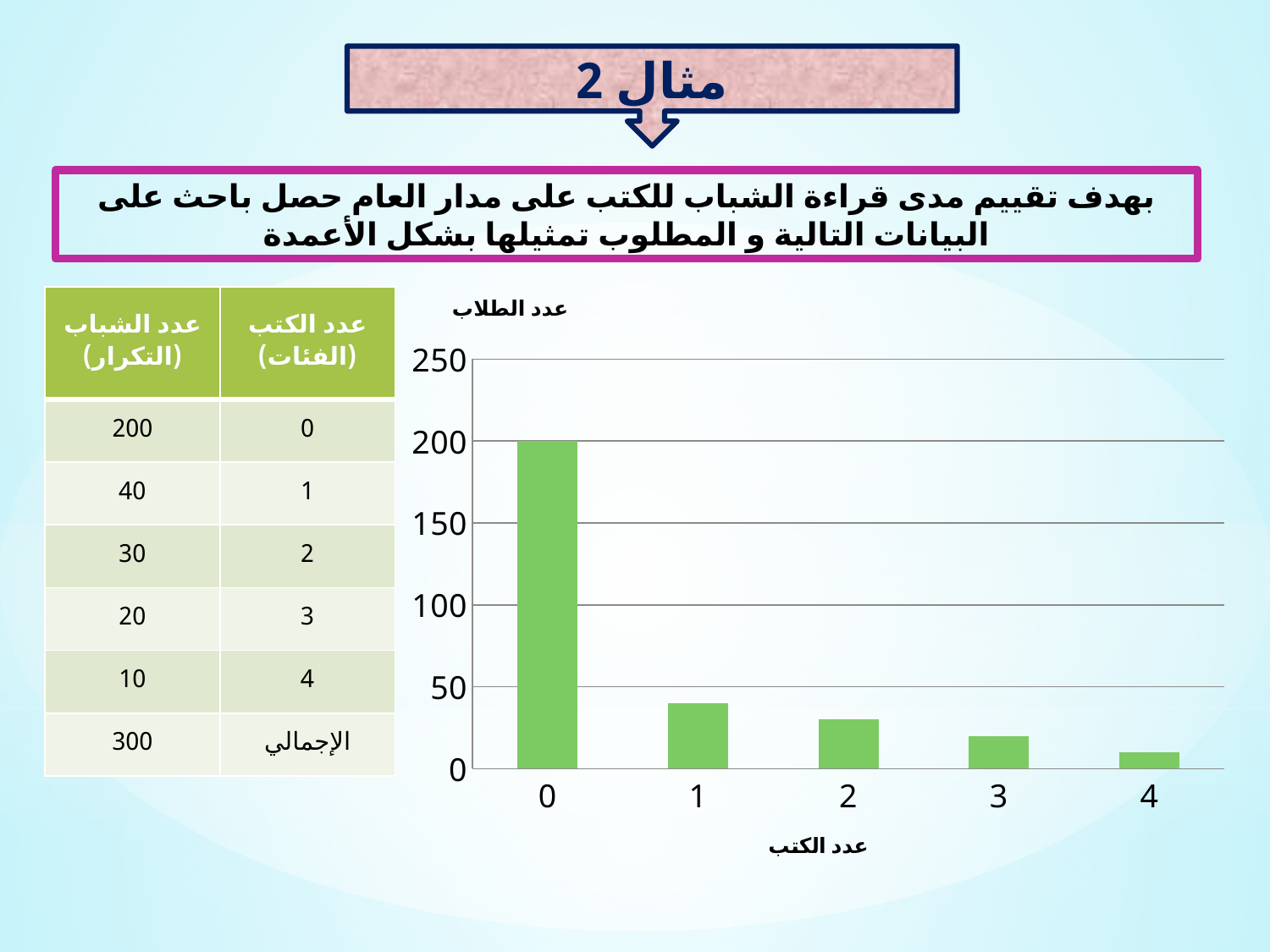
What is the value of the bar for category 1 (عدد الكتب = 1)? 40 Which category has the lowest bar? 4 What is the difference between the values for category 0 and category 1? 160 Do the bar values rise or fall as the number of books (عدد الكتب) increases along the x axis? fall What is the value of the bar for category 0 (عدد الكتب = 0)? 200 Is the value for category 0 greater or less than 150? greater What is the value of the bar for category 4 (عدد الكتب = 4)? 10 What type of chart is shown on the slide? bar chart Which is larger, the bar for category 2 or the bar for category 3? category 2 Is the value for category 1 greater or less than 50? less How many bars (categories) does the chart show? 5 Which category has the highest bar? 0